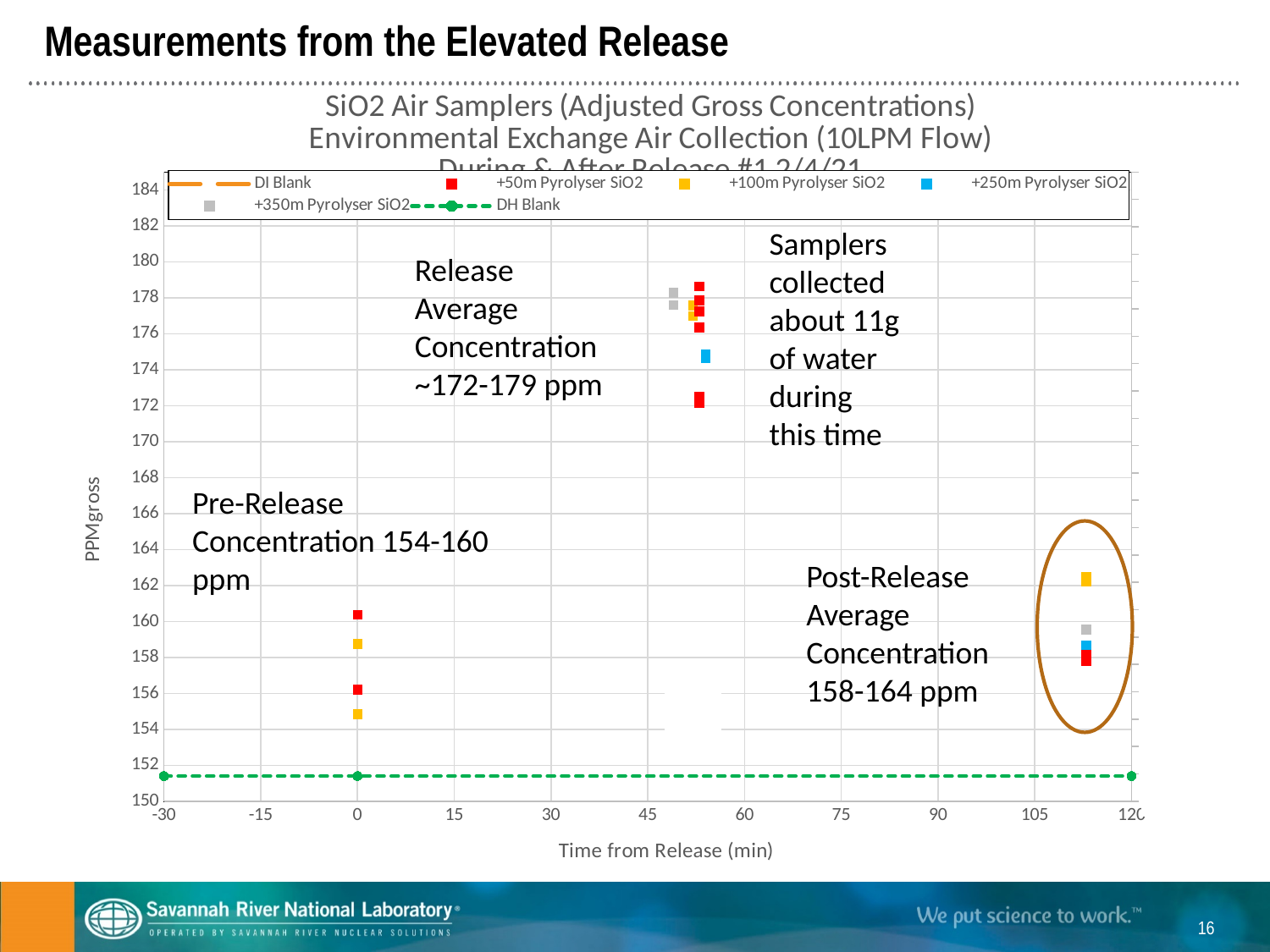
Is the DH Blank value greater or less than 152? less What kind of chart is shown on the slide? scatter chart What is the title of the x axis? Time from Release (min) After the release (around 113 min), which is larger: the +100m Pyrolyser SiO2 value or the +50m Pyrolyser SiO2 value? +100m Pyrolyser SiO2 Is the lowest +100m Pyrolyser SiO2 value at 0 min greater or less than 156? less According to the annotation on the chart, what is the Post-Release Average Concentration range? 158-164 ppm Is the value for the +100m Pyrolyser SiO2 point after the release (around 113 min) greater or less than 160? greater Does the DH Blank series rise, fall, or stay flat across the time axis? stay flat How many series does the chart legend list? 6 At 0 min, which series has the highest plotted point: +50m Pyrolyser SiO2 or +100m Pyrolyser SiO2? +50m Pyrolyser SiO2